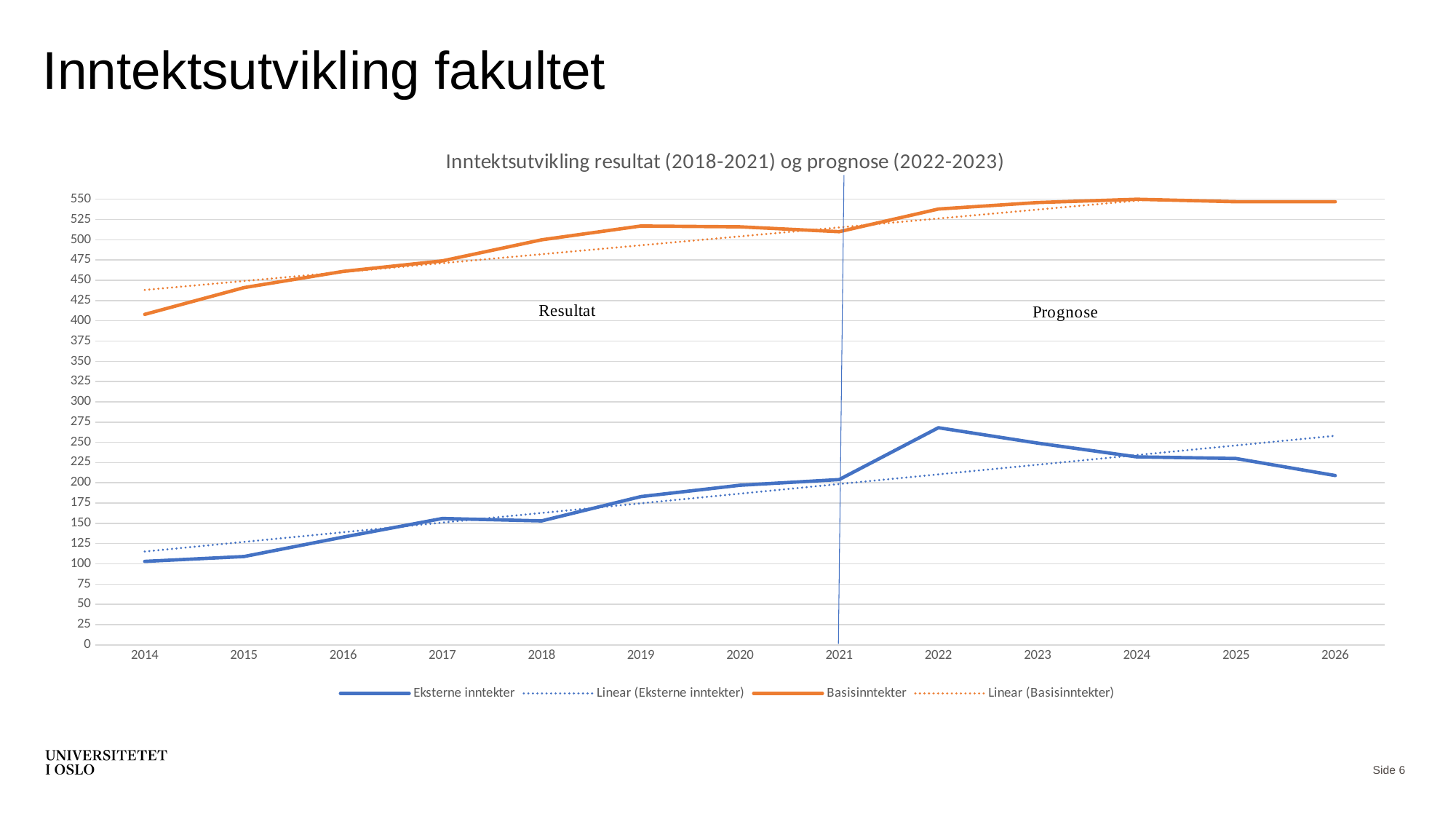
How many years are shown along the x axis of the chart? 13 Is the value for Basisinntekter in 2014 greater or less than 425? less In which year does the Eksterne inntekter line reach its highest value? 2022 What is the title of the chart? Inntektsutvikling resultat (2018-2021) og prognose (2022-2023) In which year is the Eksterne inntekter line at its lowest value? 2014 Is the value for Eksterne inntekter in 2022 greater or less than 250? greater In 2021, which series has the larger value, Basisinntekter or Eksterne inntekter? Basisinntekter What kind of chart is shown on the slide? line chart In which year is the Basisinntekter line at its lowest value? 2014 How many entries does the chart legend list? 4 Is the value for Eksterne inntekter in 2014 greater or less than 125? less Does the Basisinntekter line rise or fall from 2014 to 2019? rise